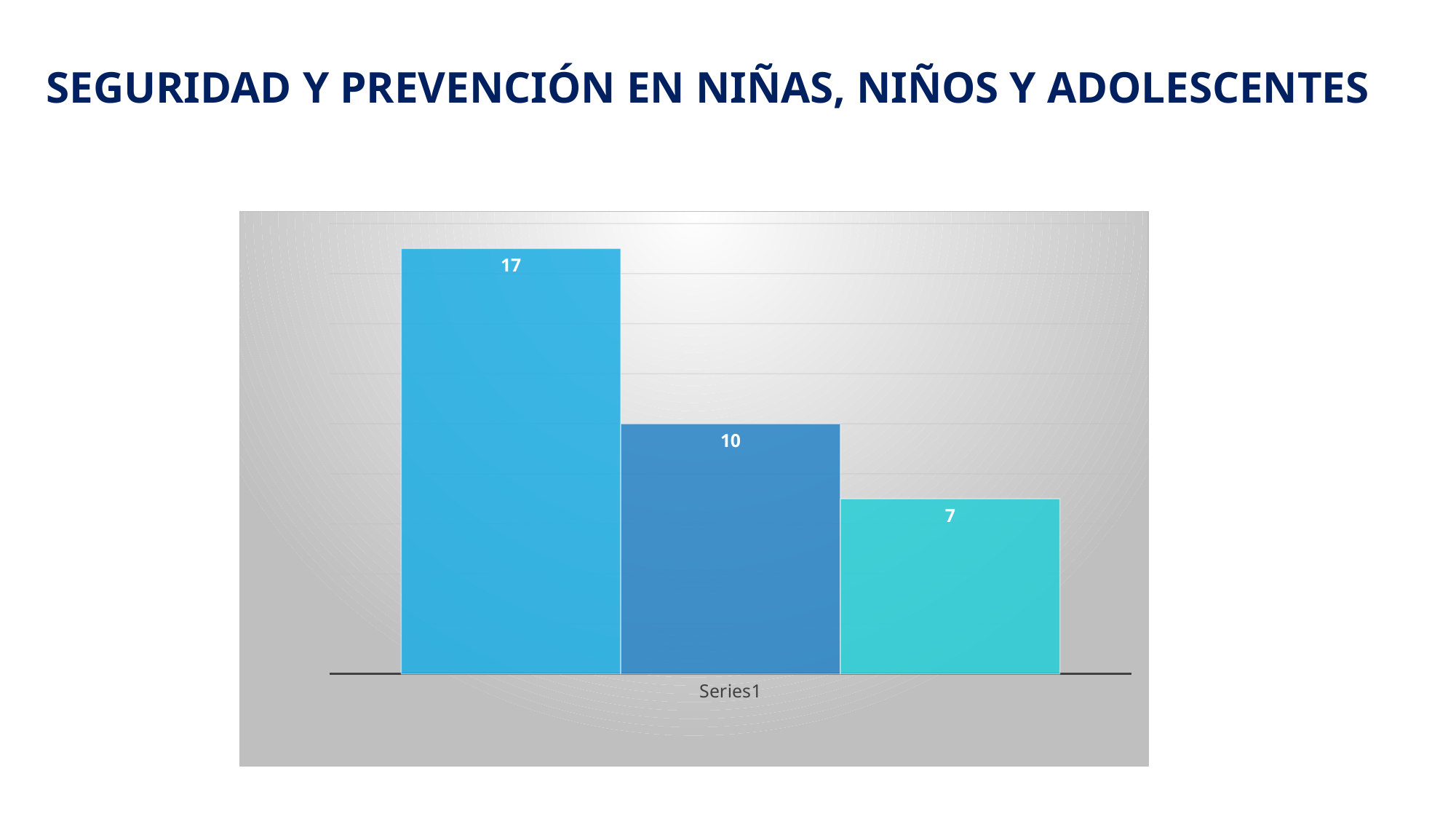
What is the lowest value shown in the chart? 7 What is the difference between the leftmost bar and the middle bar? 7 What label appears under the bars on the x axis? Series1 What is the value of the rightmost bar? 7 What is the highest value shown in the chart? 17 How many bars are plotted in the chart? 3 What is the value of the leftmost (tallest) bar? 17 Which is larger, the middle bar or the rightmost bar? the middle bar What type of chart is shown on the slide? bar chart Do the bar values rise or fall from left to right? fall What is the value of the middle bar? 10 What is the difference between the middle bar and the rightmost bar? 3